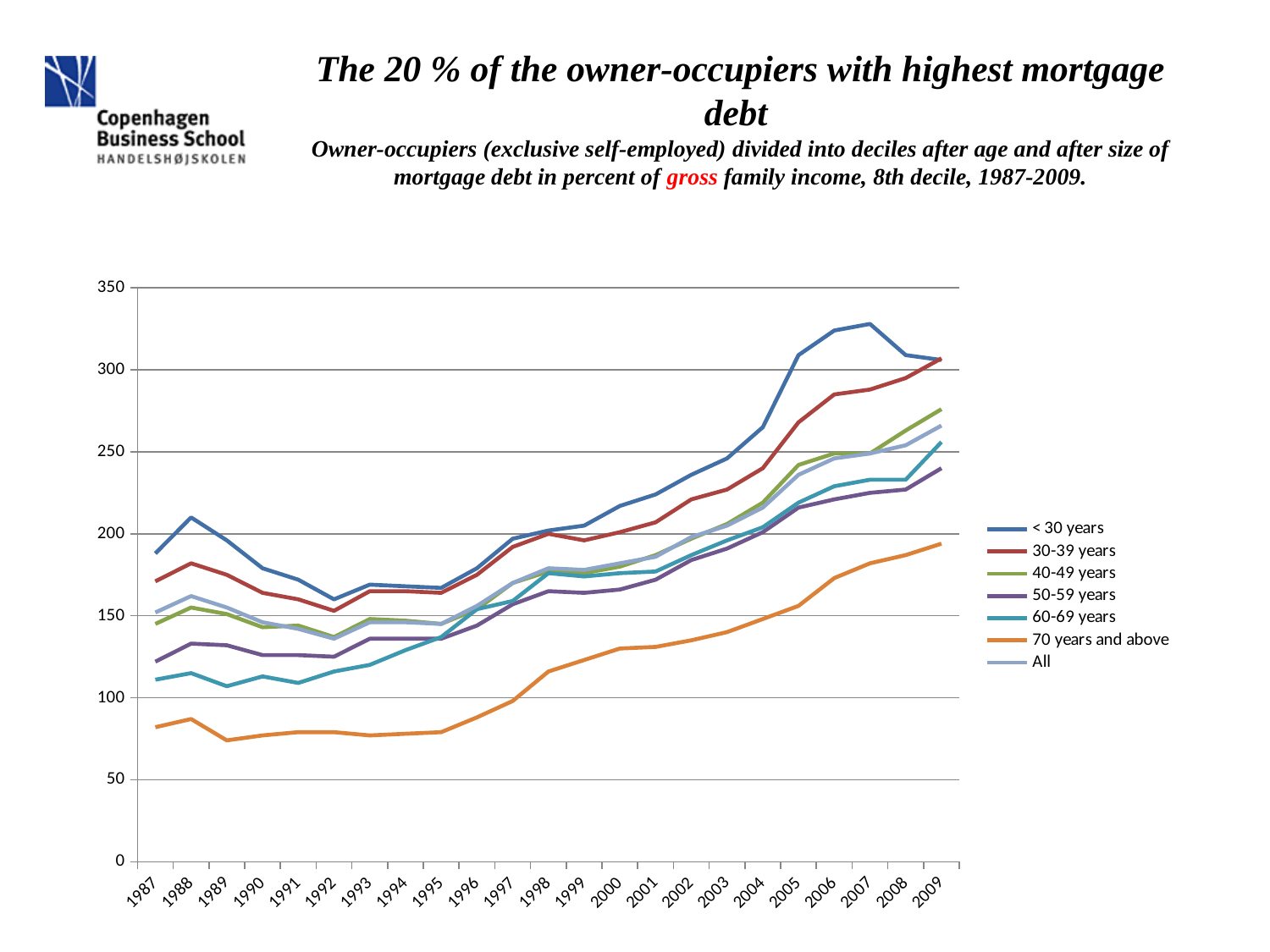
Is the value for < 30 years in 2007 greater or less than 300? greater How many years are plotted along the x axis? 23 In 2009, which is larger: the value for 40-49 years or the value for 50-59 years? 40-49 years What colour is the line for 70 years and above? Orange What kind of chart is shown on the slide? Line chart Is the value for 70 years and above in 1987 greater or less than 100? less Which series has the highest value in 2007? < 30 years Which series has the lowest value in 2009? 70 years and above Does the value for 70 years and above rise or fall from 1997 to 2009? rise Is the value for 30-39 years in 2006 greater or less than 250? greater How many series does the legend list? 7